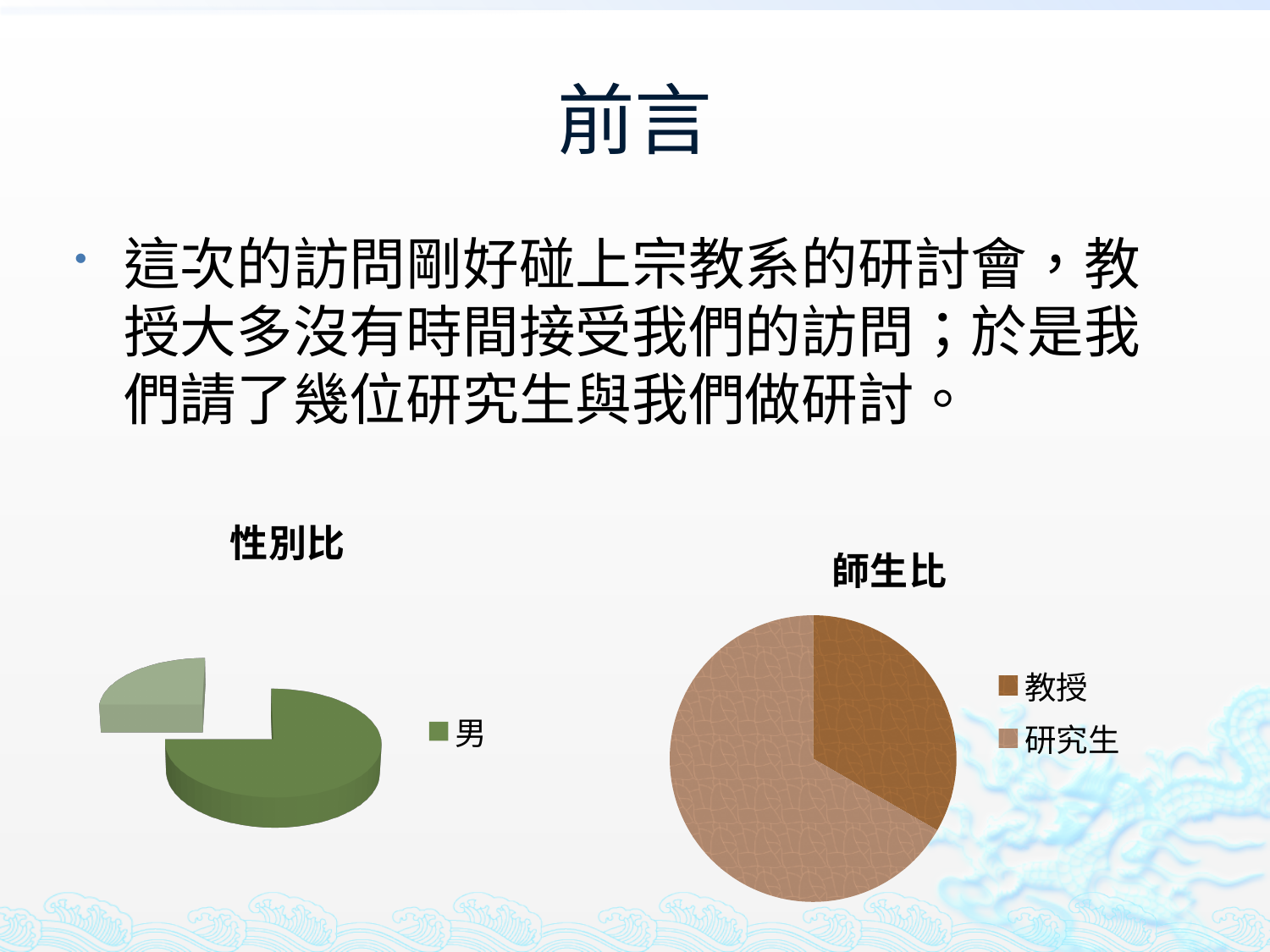
What kind of chart is the chart titled 性別比? pie chart In the chart titled 師生比, how many slices does the pie have? 2 In the chart titled 師生比, which category has the smallest share? 教授 What kind of chart is the chart titled 師生比? pie chart In the chart titled 師生比, which category has the largest share? 研究生 In the chart titled 師生比, which slice is larger, 教授 or 研究生? 研究生 In the chart titled 師生比, what are the two legend entries? 教授 and 研究生 What is the title of the pie chart on the right side of the slide? 師生比 In the chart titled 師生比, how many entries does the legend list? 2 In the chart titled 性別比, what legend entry is shown? 男